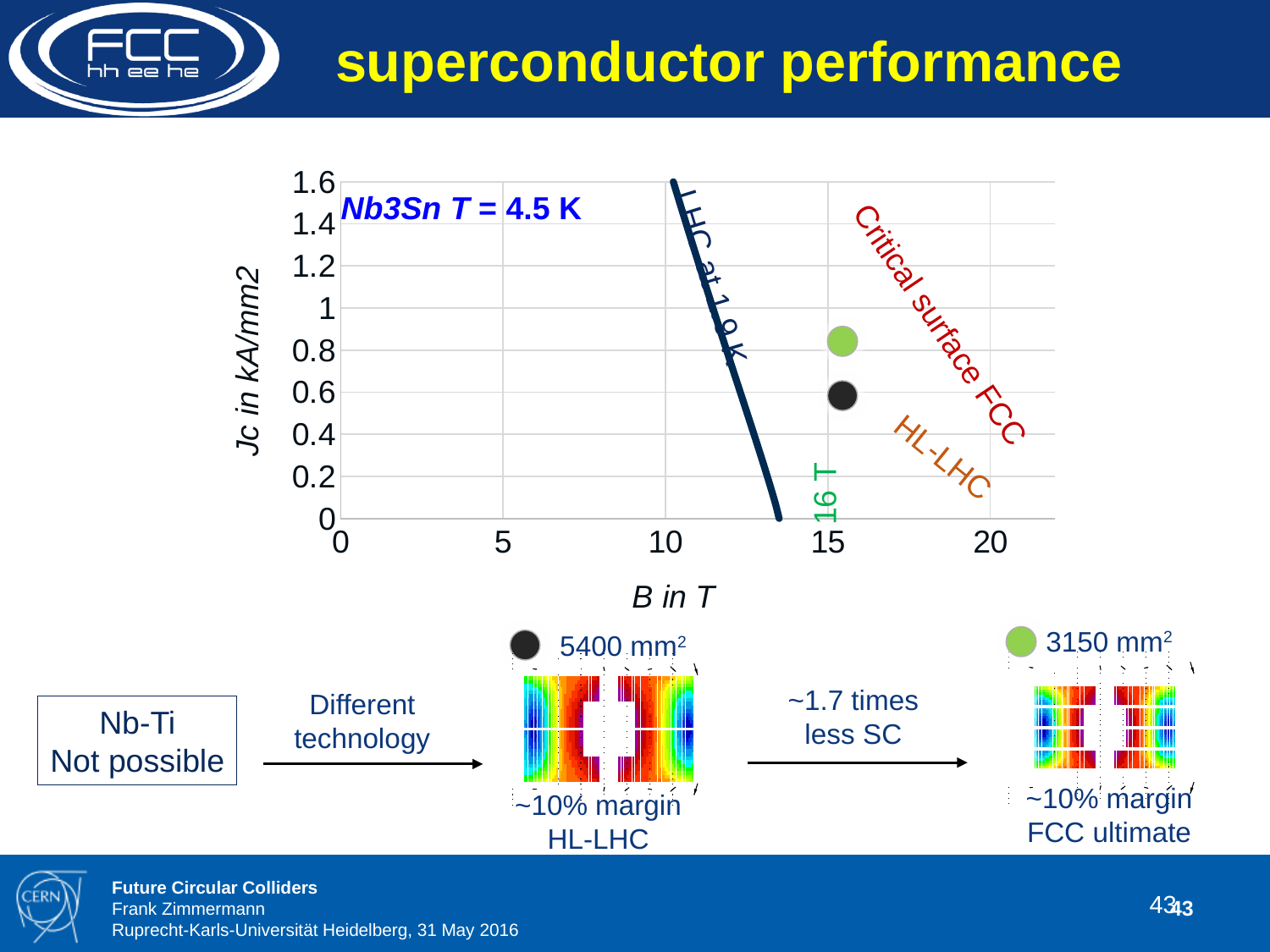
How many data points (circles) are plotted on the chart? 2 Is the B value of the green point greater or less than 10 T? greater Which plotted point has the higher Jc value, the green one or the black one? the green one What is the label of the y axis of the chart? Jc in kA/mm2 Is the Jc value where the 'LHC at 1.9 K' line reaches the x axis greater or less than 15 T? less What is the highest value shown on the y axis of the chart? 1.6 Is the Jc value of the black point greater or less than 0.4 kA/mm2? greater Does the line labelled 'LHC at 1.9 K' rise or fall as B increases? fall What kind of chart is shown on the slide? scatter chart What is the label of the x axis of the chart? B in T